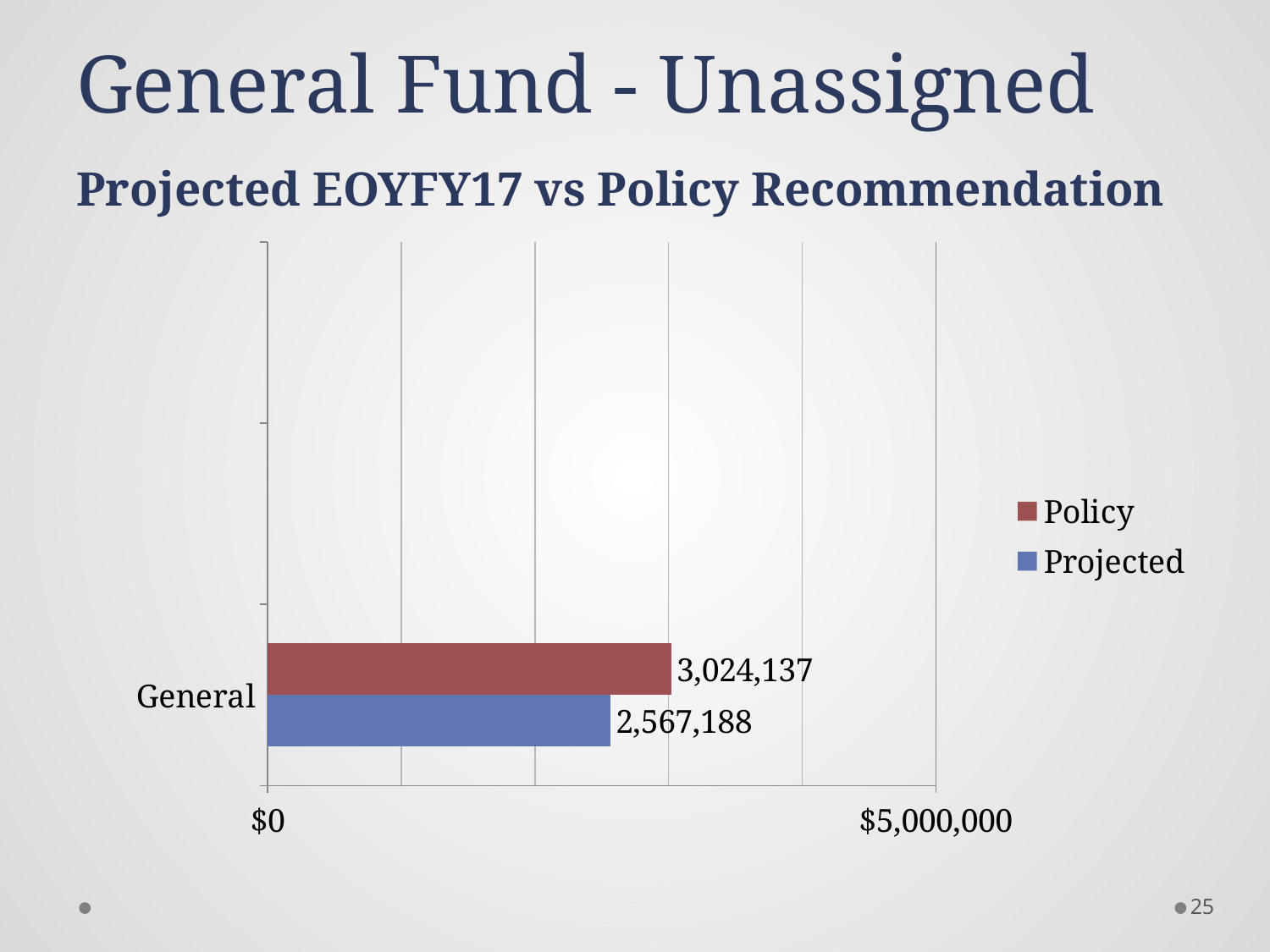
What is the difference between the Policy and Projected values for General? 456,949 How many series does the legend list? 2 Is the Projected value for General greater or less than $5,000,000? less What kind of chart is shown on the slide? bar chart What is the Projected value for General? 2,567,188 What is the maximum value shown on the x axis? $5,000,000 Which series is shown in red? Policy What is the title of the chart? Projected EOYFY17 vs Policy Recommendation Which series has the larger value for General, Policy or Projected? Policy How many categories are shown on the chart? 1 What is the Policy value for General? 3,024,137